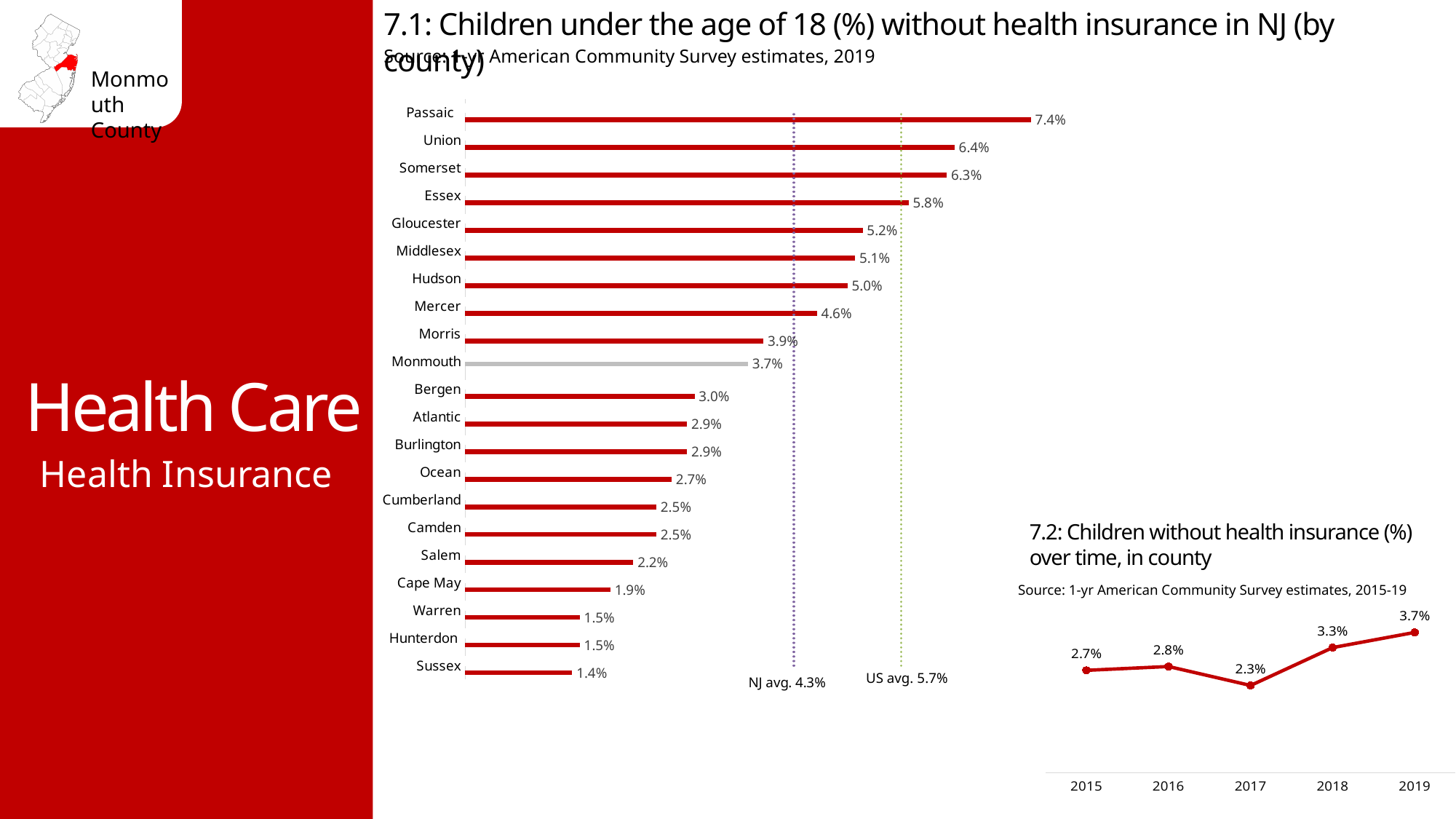
In chart 7.1, which county has the lowest percentage of children without health insurance? Sussex In chart 7.1, which county has the highest percentage of children without health insurance? Passaic In chart 7.1, which county has a larger value, Essex or Mercer? Essex What kind of chart is chart 7.1? Bar chart In chart 7.2 (children without health insurance over time), what is the value for 2017? 2.3% In chart 7.1 (children under 18 without health insurance by county), what is the value for Monmouth? 3.7% In chart 7.2, what is the difference between the values for 2019 and 2015? 1.0% In chart 7.1, what is the NJ average shown by the dotted reference line? 4.3% What kind of chart is chart 7.2? Line chart In chart 7.1, how many counties are shown? 21 In chart 7.1, what is the difference between the values for Passaic and Sussex? 6.0% In chart 7.2, which year has the highest value? 2019